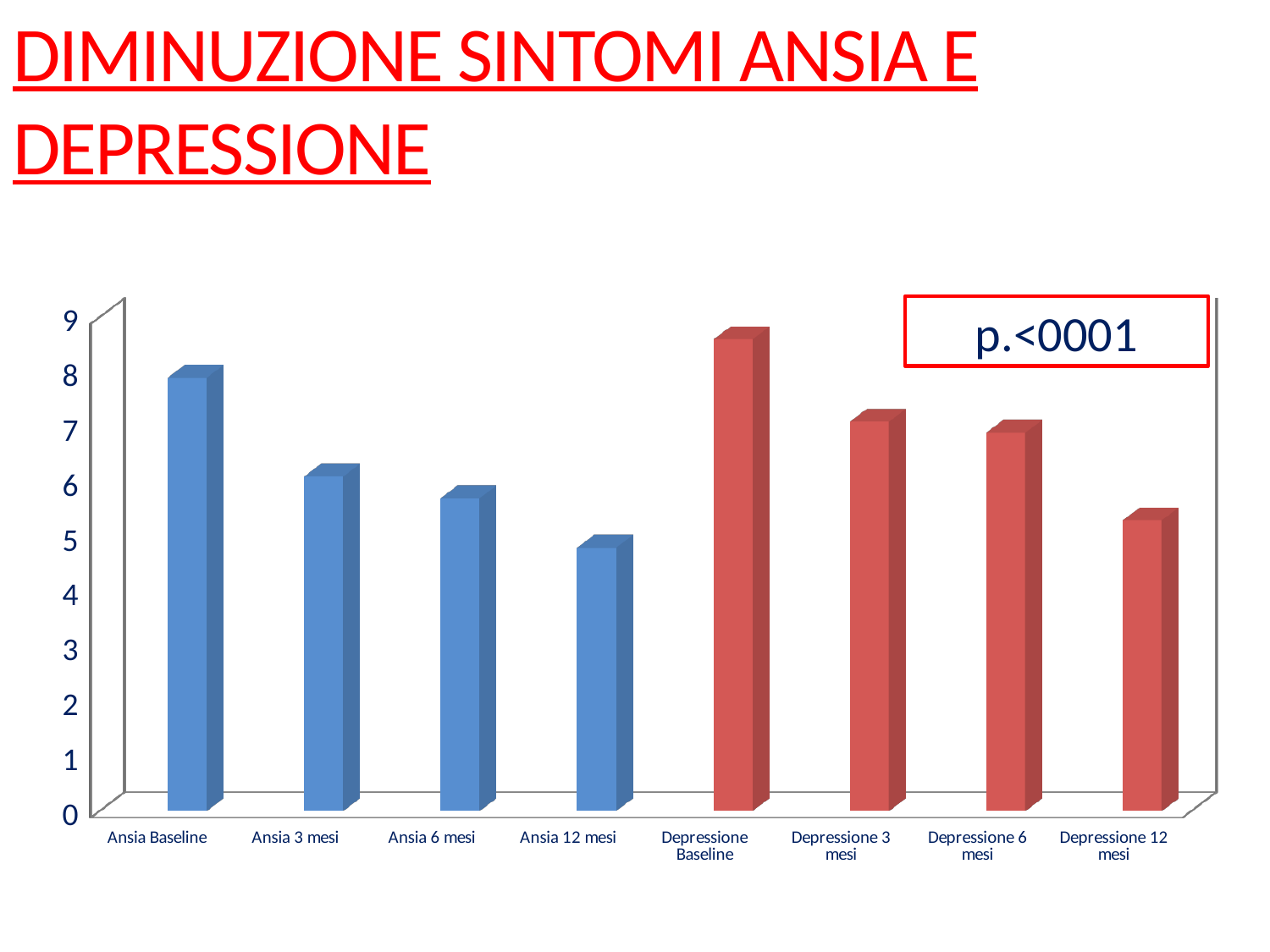
Which category has the highest bar in the chart? Depressione Baseline Is the value for Depressione Baseline greater or less than 8? greater Which is larger, the value for Ansia 12 mesi or the value for Depressione 12 mesi? Depressione 12 mesi Do the Ansia values rise or fall from Baseline to 12 mesi? fall Is the value for Depressione 12 mesi greater or less than 6? less Is the value for Ansia Baseline greater or less than 7? greater What p-value is shown in the box on the chart? p.<0001 Which is larger, the value for Ansia Baseline or the value for Depressione Baseline? Depressione Baseline Which category has the lowest bar in the chart? Ansia 12 mesi How many bars (categories) are plotted in the chart? 8 What kind of chart is shown on the slide? bar chart